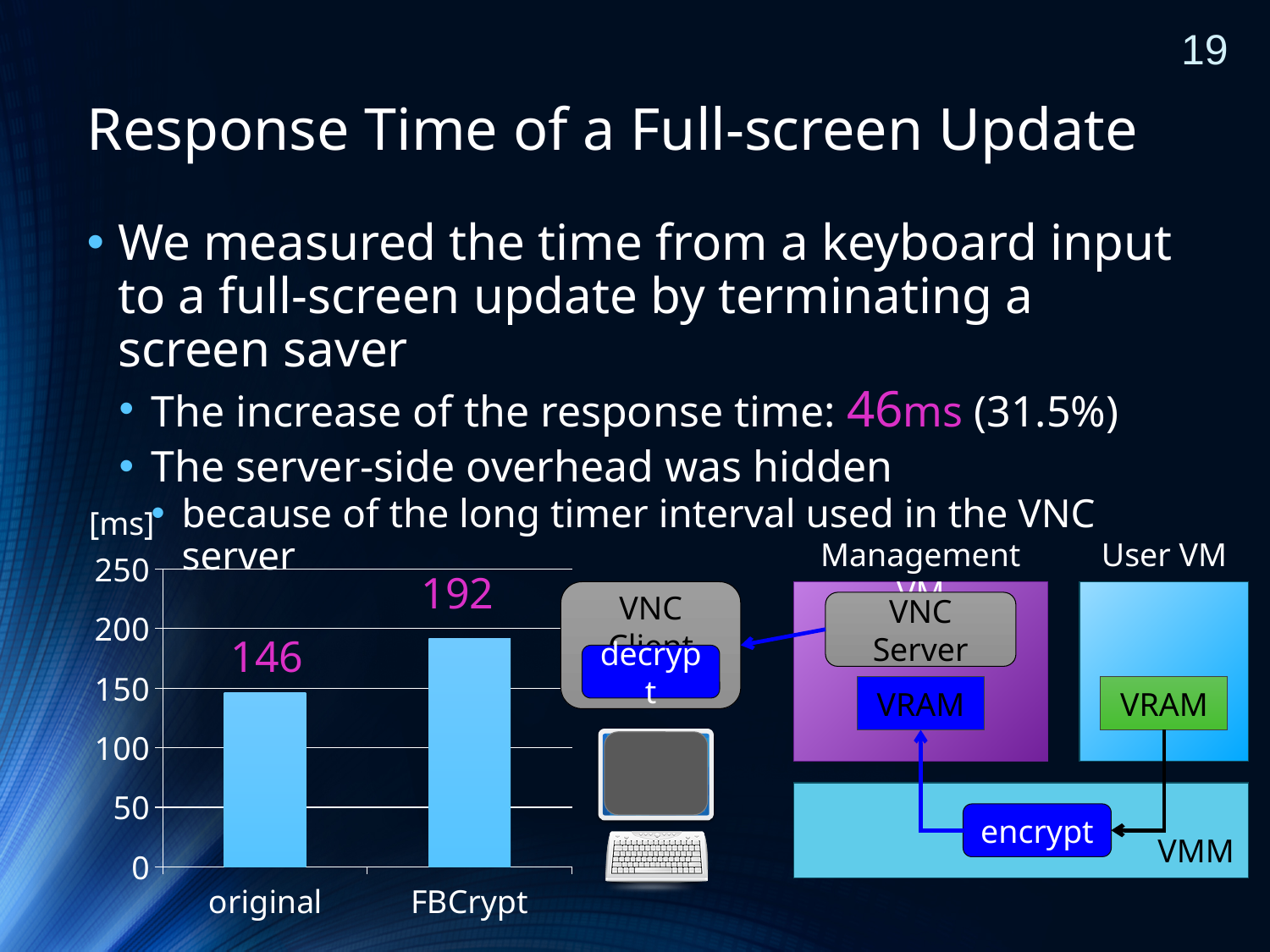
How many categories are shown in the chart? 2 What unit is shown on the chart's vertical axis? [ms] What is the response time for FBCrypt? 192 Is the value for FBCrypt greater or less than 200? less Is the value for original greater or less than 150? less Which category has the lowest response time? original What is the response time for original? 146 What kind of chart is shown on the slide? bar chart Which category has the highest response time? FBCrypt Which has a larger response time, original or FBCrypt? FBCrypt What is the difference in response time between FBCrypt and original? 46 What is the maximum value shown on the chart's vertical axis? 250